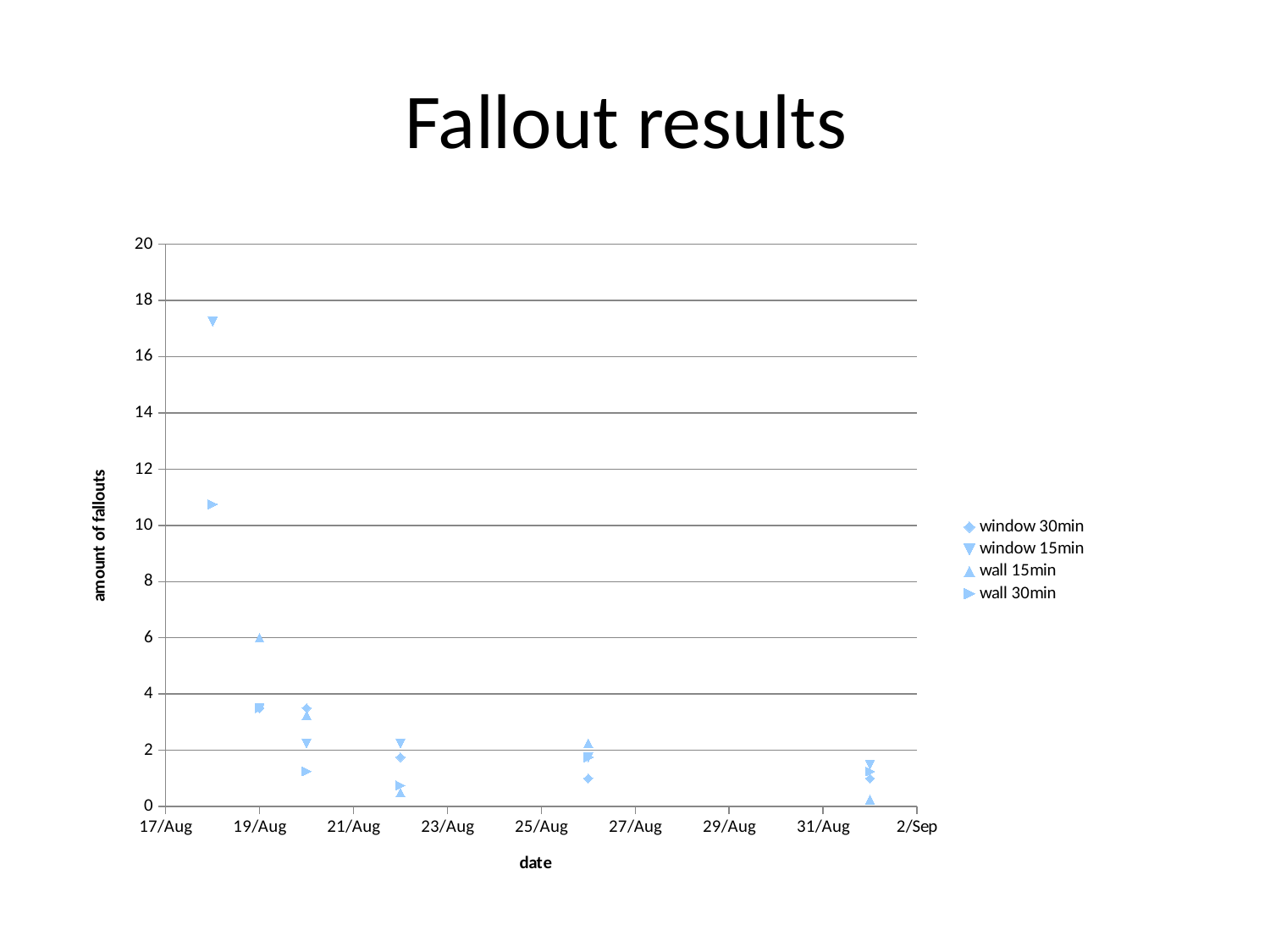
What is the label on the vertical axis? amount of fallouts Is the highest window 15min value greater or less than 18? less Which is larger on 18/Aug: the window 15min value or the wall 30min value? window 15min What is the title of the chart? Fallout results Is the highest window 15min value greater or less than 16? greater Is the wall 30min value on 18/Aug greater or less than 10? greater Do the plotted values generally rise or fall from 17/Aug to 2/Sep? fall Which series has the highest plotted point on the chart? window 15min What kind of chart is shown on the slide? scatter chart How many series does the legend list? 4